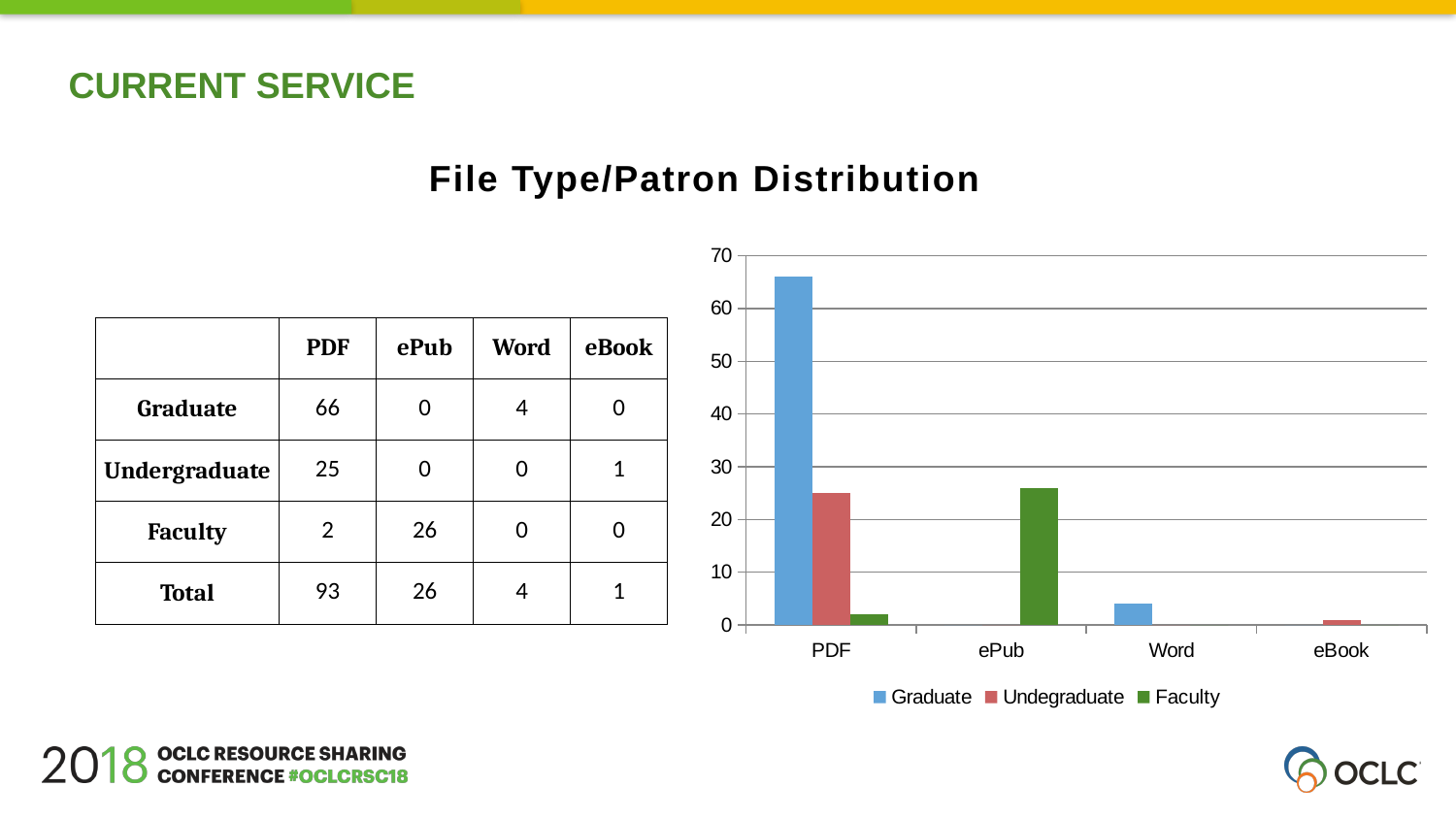
How many file type categories are shown on the chart's x axis? 4 What is the value for Graduate in the PDF category? 66 What is the value for Undergraduate in the PDF category? 25 Is the Graduate value for PDF greater or less than 60? greater What is the value for Faculty in the ePub category? 26 What is the title of the chart? File Type/Patron Distribution Which series has the lowest value in the PDF category? Faculty Which file type category has the highest Graduate value? PDF What kind of chart is shown on the slide? bar chart Which is larger: the Graduate value for Word or the Faculty value for ePub? Faculty value for ePub How many series does the chart legend list? 3 What is the difference between the Graduate and Undergraduate values for PDF? 41